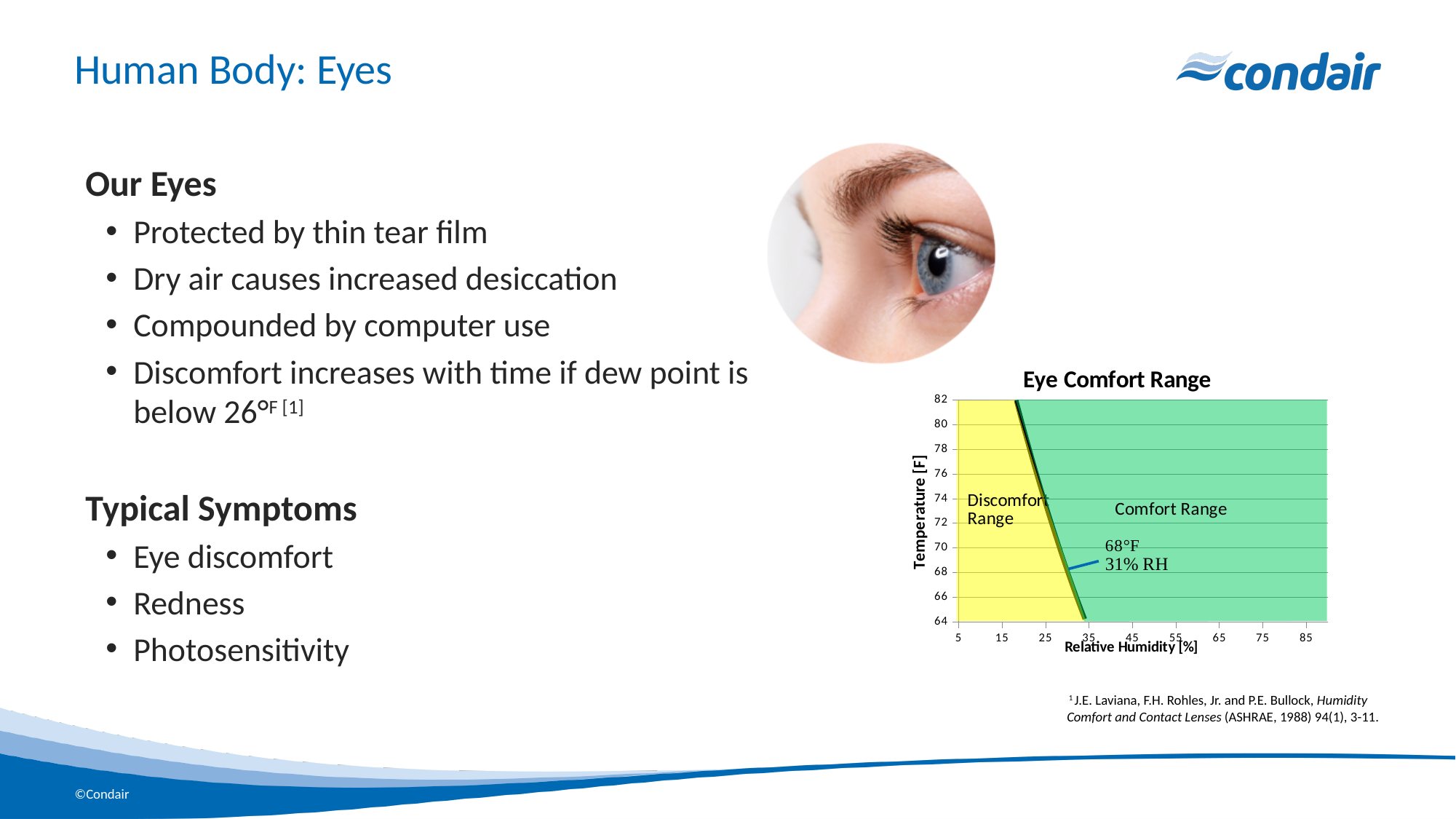
What kind of chart is the Eye Comfort Range chart? area chart What is the title of the chart on the slide? Eye Comfort Range What temperature is given in the annotation on the boundary line of the Eye Comfort Range chart? 68°F What is the label of the y axis of the Eye Comfort Range chart? Temperature [F] What is the label of the x axis of the Eye Comfort Range chart? Relative Humidity [%] How many labelled regions are shown in the Eye Comfort Range chart? 2 In the Eye Comfort Range chart, which region covers the larger area, the Discomfort Range or the Comfort Range? Comfort Range What is the highest temperature tick shown on the y axis of the Eye Comfort Range chart? 82 What relative humidity is given in the annotation on the boundary line of the Eye Comfort Range chart? 31% RH In the Eye Comfort Range chart, does the relative humidity at the boundary between the Discomfort Range and the Comfort Range rise or fall as temperature increases? fall What is the lowest temperature tick shown on the y axis of the Eye Comfort Range chart? 64 In the Eye Comfort Range chart, is the relative humidity at the boundary line at 82°F greater or less than 25%? less